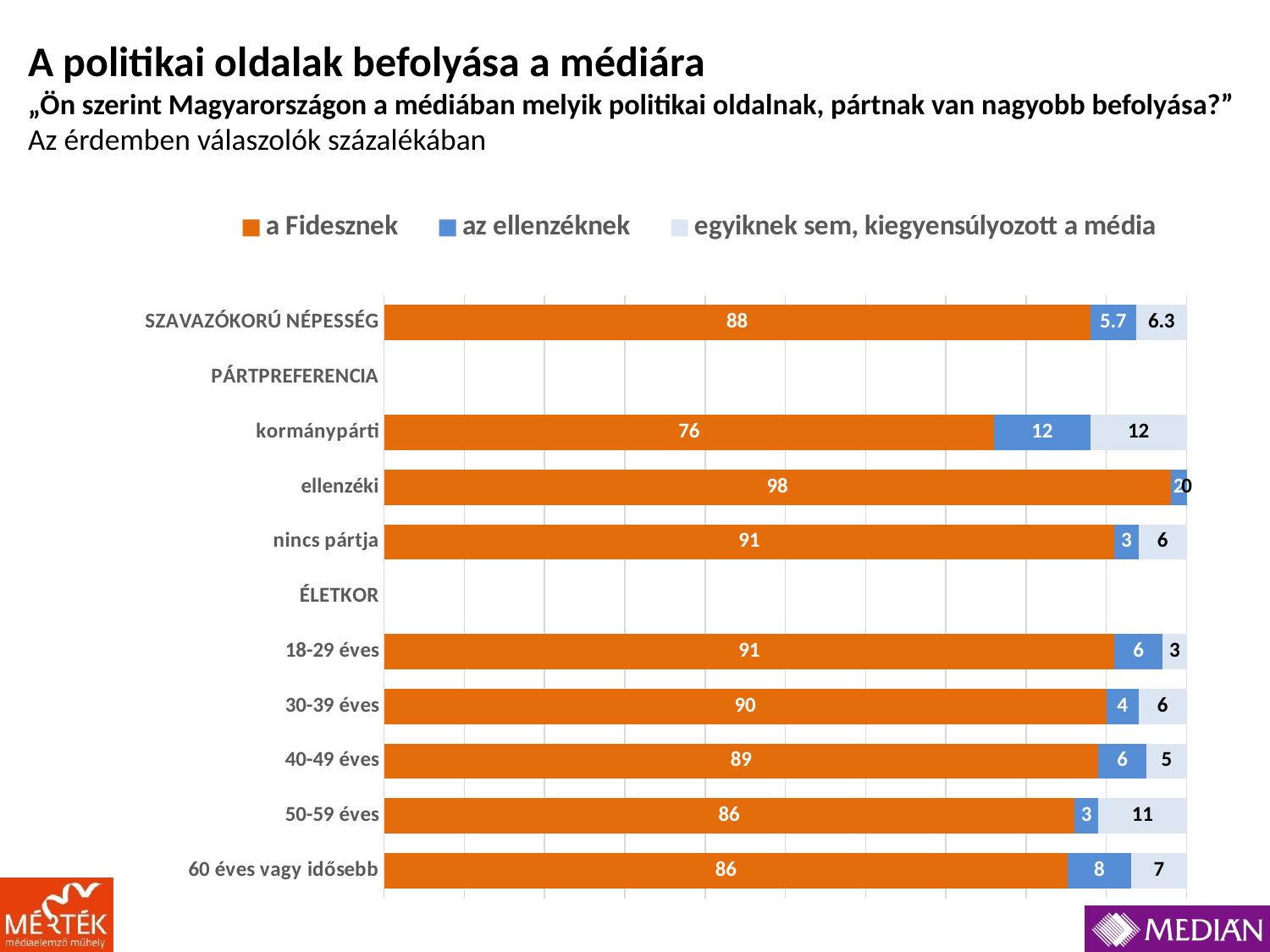
What is the value for "az ellenzéknek" in the SZAVAZÓKORÚ NÉPESSÉG category? 5.7 Which has a larger value for "az ellenzéknek": kormánypárti or 60 éves vagy idősebb? kormánypárti What kind of chart is shown on the slide? Stacked bar chart What is the value for "egyiknek sem, kiegyensúlyozott a média" in the 50-59 éves category? 11 What is the difference between the "a Fidesznek" values for 18-29 éves and 60 éves vagy idősebb? 5 What is the value for "a Fidesznek" in the kormánypárti category? 76 How many age-group categories are listed under ÉLETKOR? 5 What is the value for "az ellenzéknek" in the 30-39 éves category? 4 Which category has the highest value for "a Fidesznek"? ellenzéki How many series does the legend list? 3 What is the total of the stacked bar for kormánypárti? 100 Which category has the lowest value for "a Fidesznek"? kormánypárti